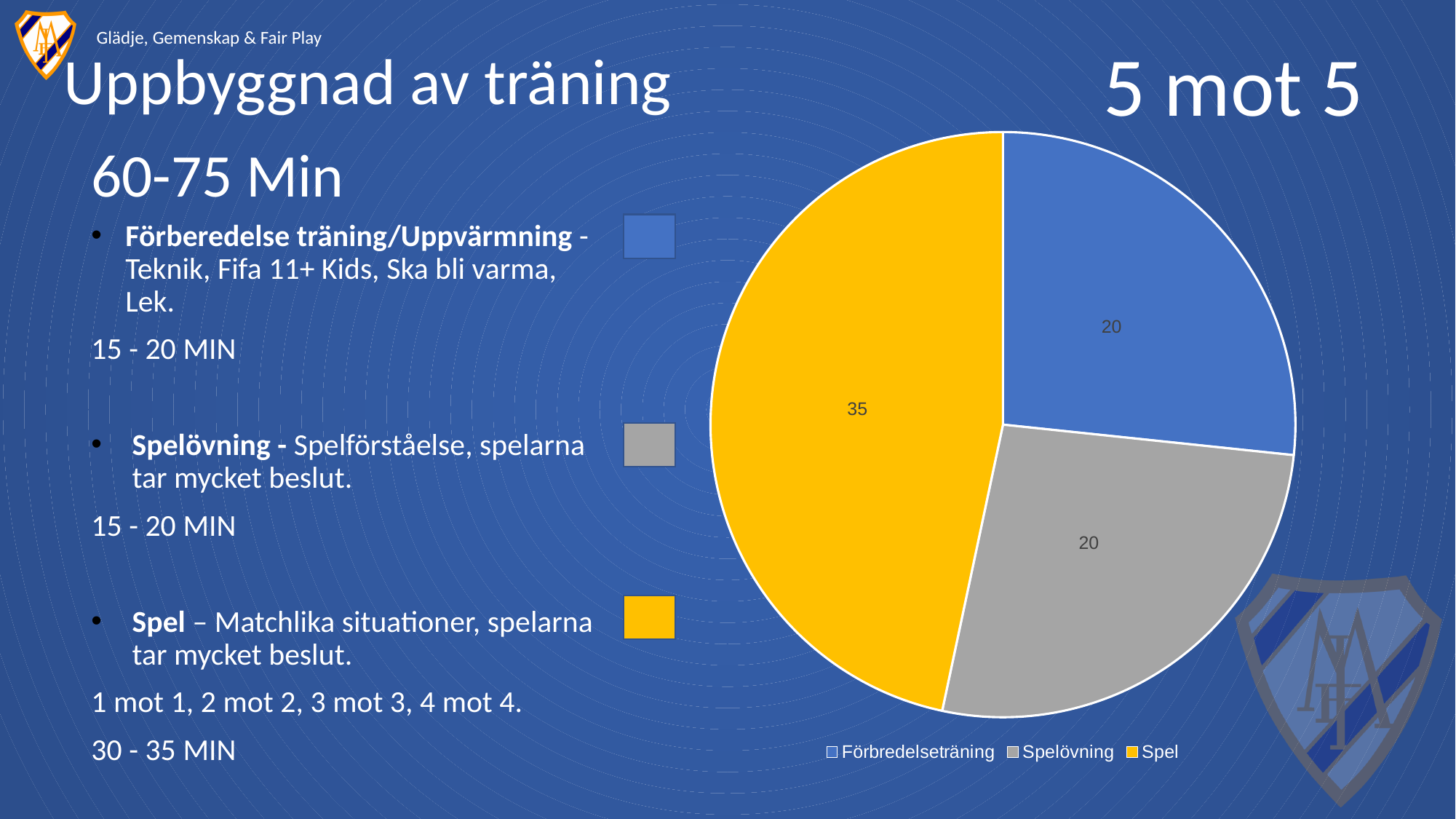
Which category has the largest slice in the pie chart? Spel What colour is the Spel slice in the pie chart? Yellow How many slices does the pie chart have? 3 What is the difference between the values for Spel and Spelövning in the pie chart? 15 Which legend entry is shown in grey in the pie chart? Spelövning What value is shown for the Spelövning slice of the pie chart? 20 What value is shown for the Spel slice of the pie chart? 35 What kind of chart is shown on the slide? Pie chart What is the total of all the values shown in the pie chart? 75 What value is shown for the Förbredelseträning slice of the pie chart? 20 Which is larger in the pie chart, Spel or Förbredelseträning? Spel How many entries does the pie chart's legend list? 3